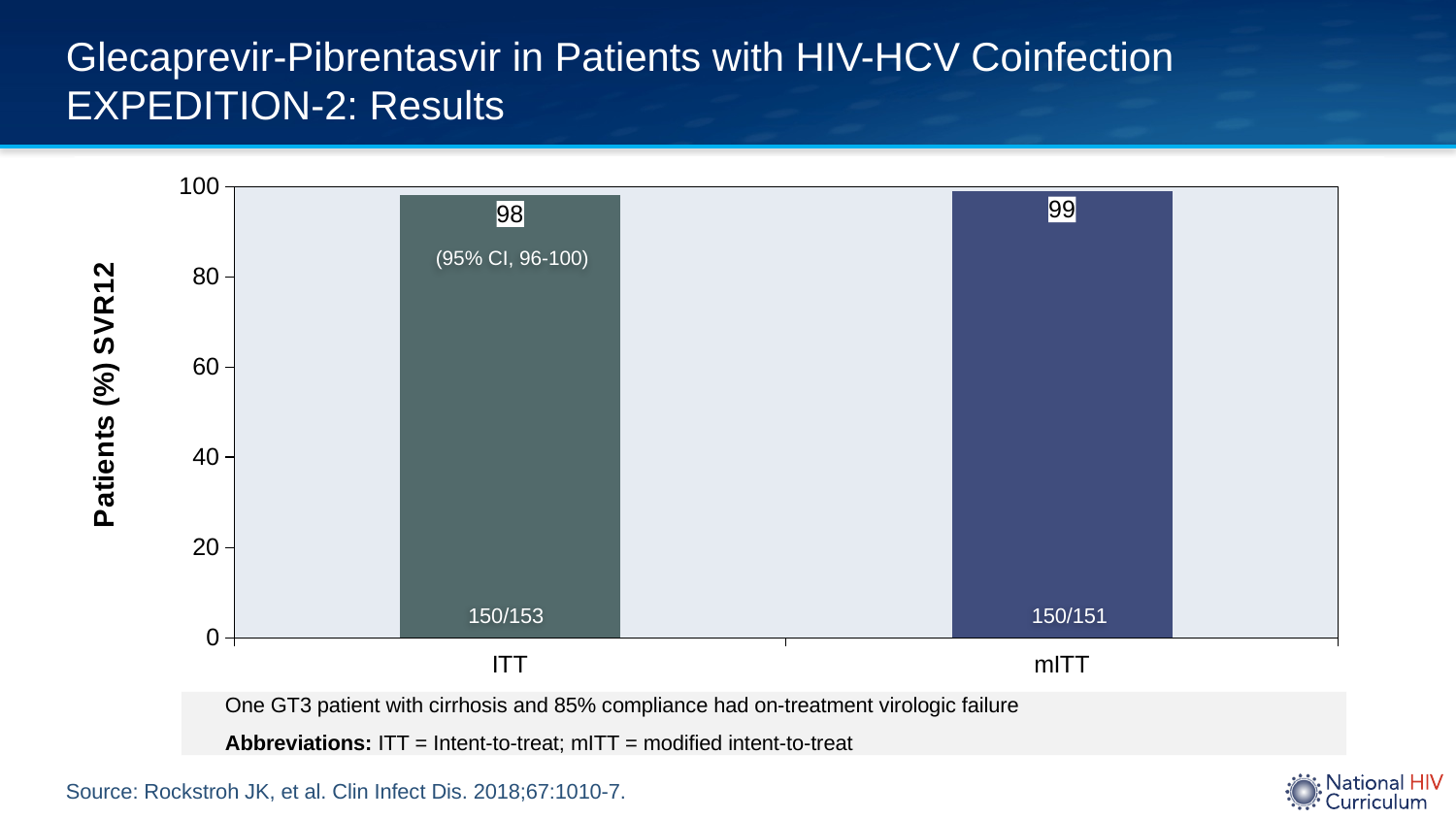
What is the difference in SVR12 rate (%) between the mITT and ITT groups? 1 What is the label of the y axis? Patients (%) SVR12 Which group has the higher SVR12 rate, ITT or mITT? mITT What is the 95% confidence interval shown for the ITT group? 96-100 What fraction of patients achieved SVR12 in the ITT group? 150/153 Is the SVR12 rate for the ITT group greater or less than 80? greater What kind of chart is shown on the slide? Bar chart What is the SVR12 rate (%) for the mITT group? 99 What is the SVR12 rate (%) for the ITT group? 98 What fraction of patients achieved SVR12 in the mITT group? 150/151 What is the maximum value shown on the y axis? 100 How many categories are shown on the x axis? 2